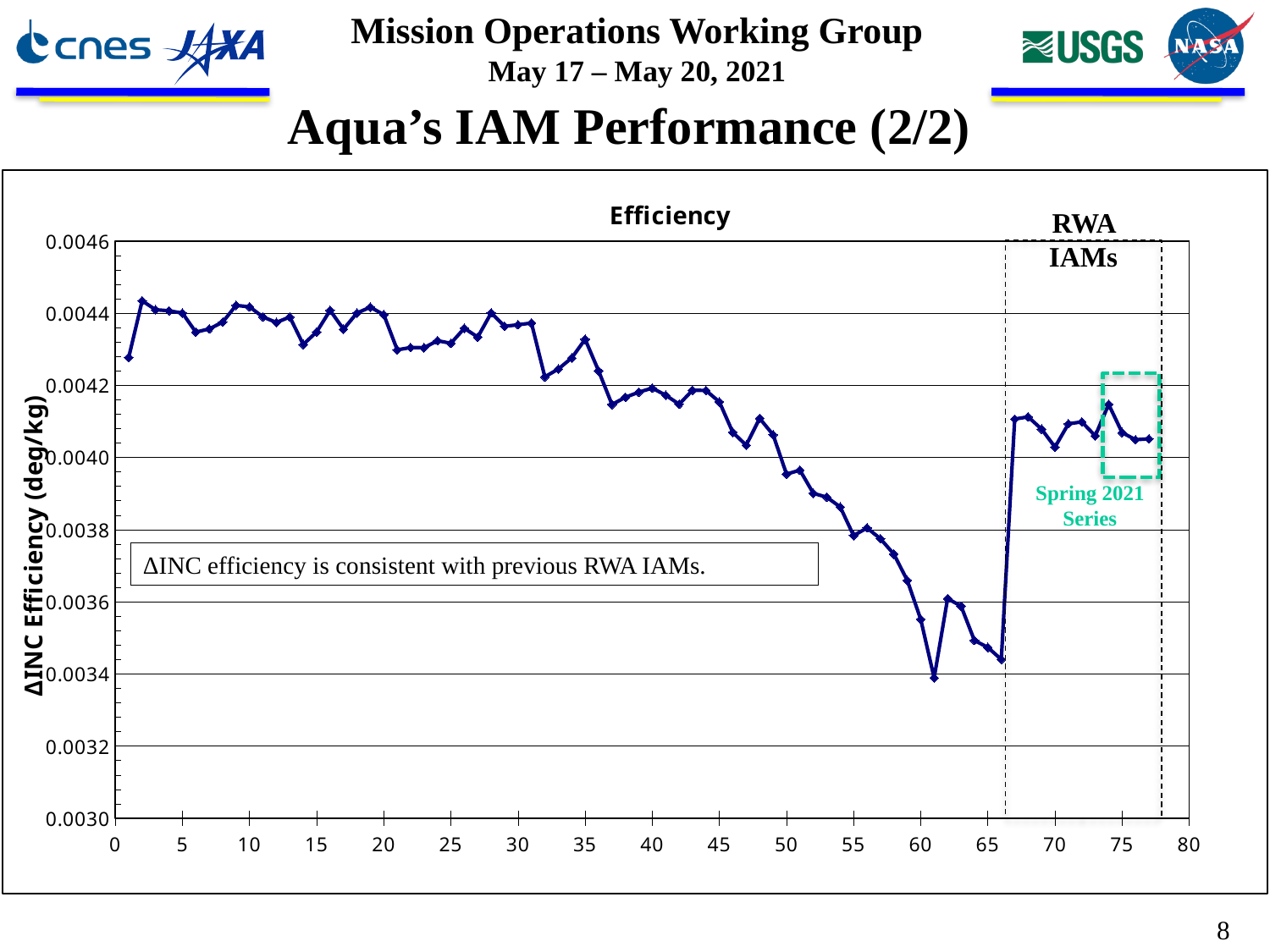
Do the values generally rise or fall along the x axis between x = 35 and x = 61? fall What is the title of the chart? Efficiency Is the value at x = 2 larger or smaller than the value at x = 61? larger Is the value at x = 66 greater or less than 0.0036? less Is the value at x = 50 greater or less than 0.0042? less What is the label of the y axis of the chart? ΔINC Efficiency (deg/kg) Is the value at x = 40 greater or less than 0.0040? greater What kind of chart is shown on the slide? line chart At which x value does the line reach its lowest point? 61